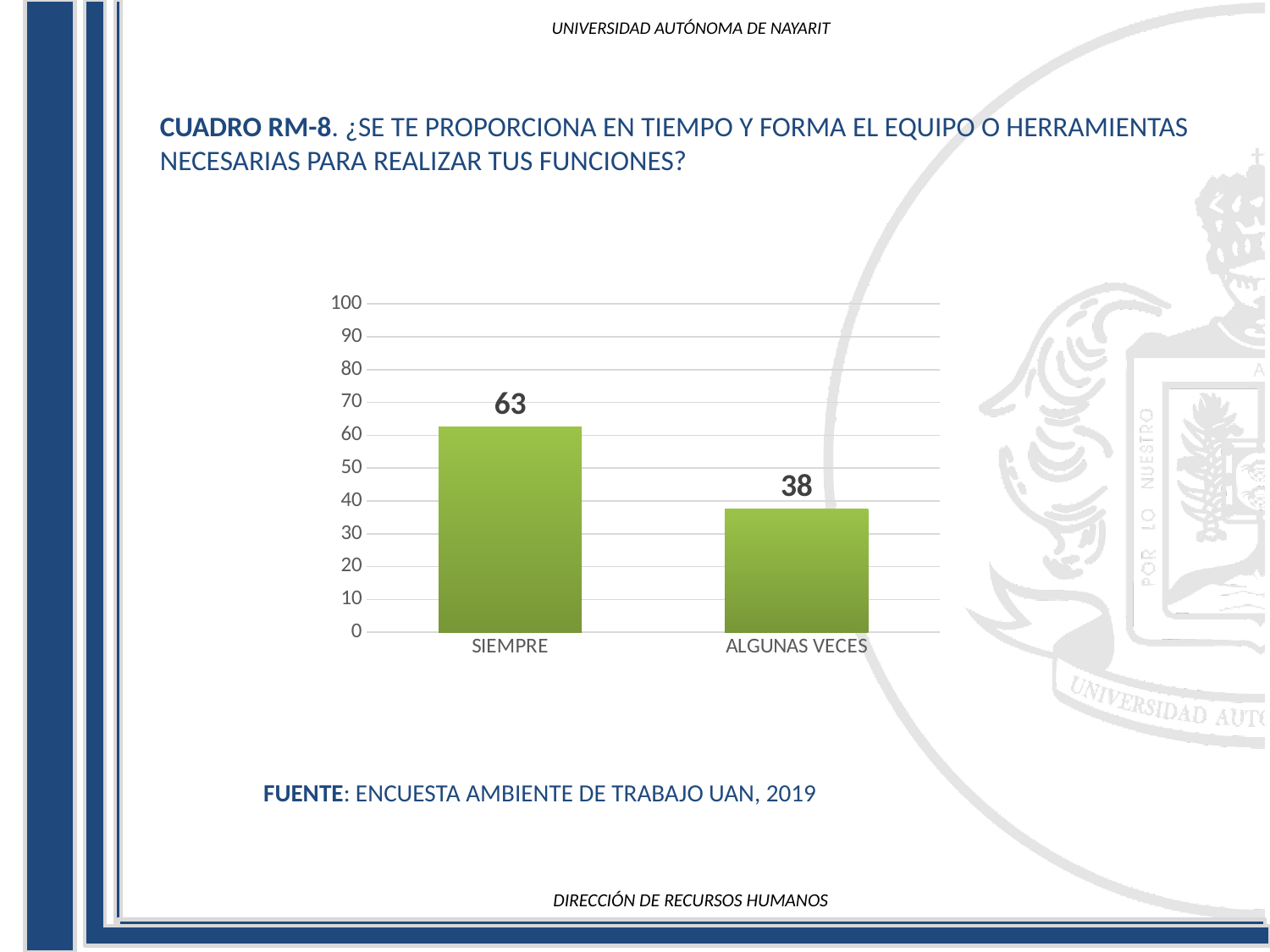
Which is larger, the value for SIEMPRE or the value for ALGUNAS VECES? SIEMPRE Which category has the highest value? SIEMPRE Which category has the lowest value? ALGUNAS VECES What is the maximum value shown on the y axis? 100 What kind of chart is shown on the slide? bar chart How many categories are shown on the x axis? 2 Is the value for ALGUNAS VECES greater or less than 50? less What is the value for ALGUNAS VECES? 38 What is the total of the two bar values? 101 What is the value for SIEMPRE? 63 What is the difference between the values for SIEMPRE and ALGUNAS VECES? 25 Is the value for SIEMPRE greater or less than 60? greater